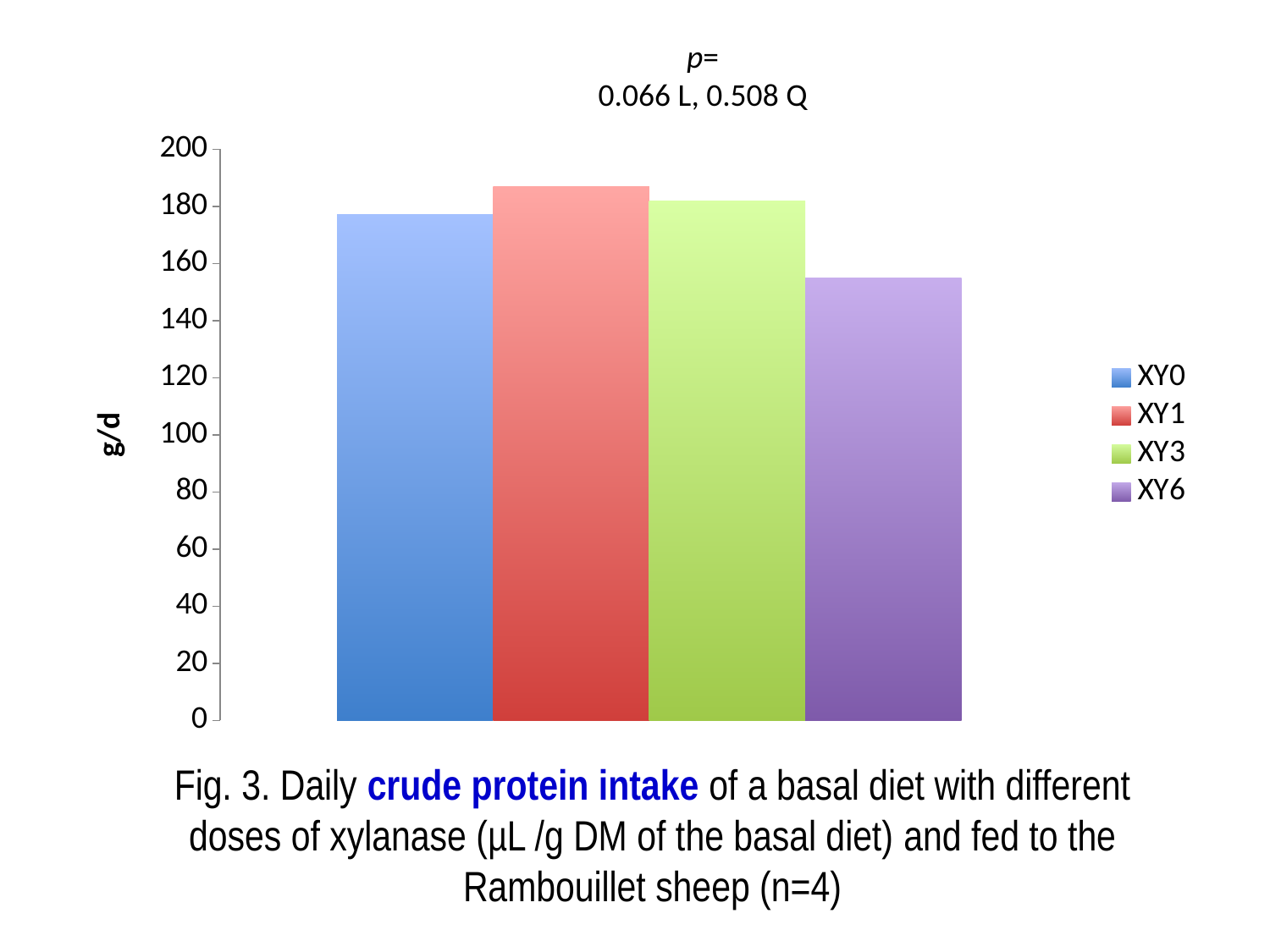
What is the label on the vertical axis of the chart? g/d How many bars are plotted in the chart? 4 What are the legend entries listed for the chart? XY0, XY1, XY3, XY6 What kind of chart is shown on the slide? bar chart Is the value for XY0 greater or less than 160? greater Which treatment has the highest daily crude protein intake? XY1 Which is larger, the value for XY0 or the value for XY6? XY0 Is the value for XY1 greater or less than 180? greater Is the value for XY6 greater or less than 160? less How many entries does the legend list? 4 Which is larger, the value for XY1 or the value for XY6? XY1 Which treatment has the lowest daily crude protein intake? XY6